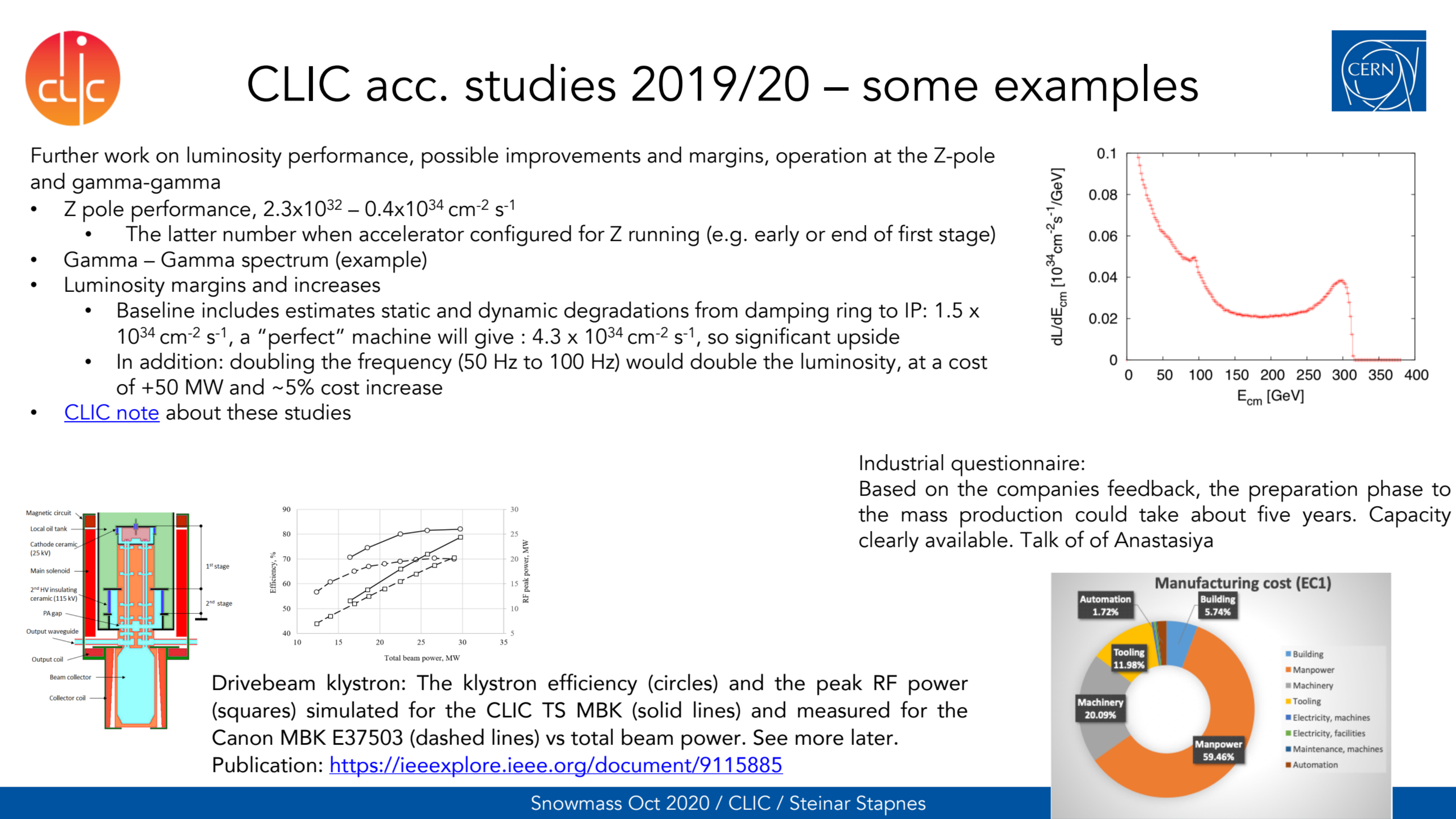
In the Manufacturing cost (EC1) chart, what is the difference between the Machinery and Tooling shares? 8.11% How many entries does the legend of the Manufacturing cost (EC1) chart list? 8 In the gamma-gamma spectrum chart at the top right, does the curve rise or fall between E_cm = 0 and 150 GeV? fall In the Manufacturing cost (EC1) chart, what is the share for Machinery? 20.09% In the Manufacturing cost (EC1) chart, which is larger, Building or Automation? Building In the Manufacturing cost (EC1) chart, what is the share for Tooling? 11.98% In the Manufacturing cost (EC1) chart, which category has the largest share? Manpower What is the x-axis label of the drivebeam klystron chart at the bottom middle? Total beam power, MW What kind of chart is the Manufacturing cost (EC1) chart? Pie (donut) chart In the gamma-gamma spectrum chart at the top right, is the value at E_cm = 50 GeV greater or less than 0.04? greater In the gamma-gamma spectrum chart at the top right, is the value at E_cm = 350 GeV greater or less than 0.02? less In the Manufacturing cost (EC1) chart, what share does Manpower have? 59.46%